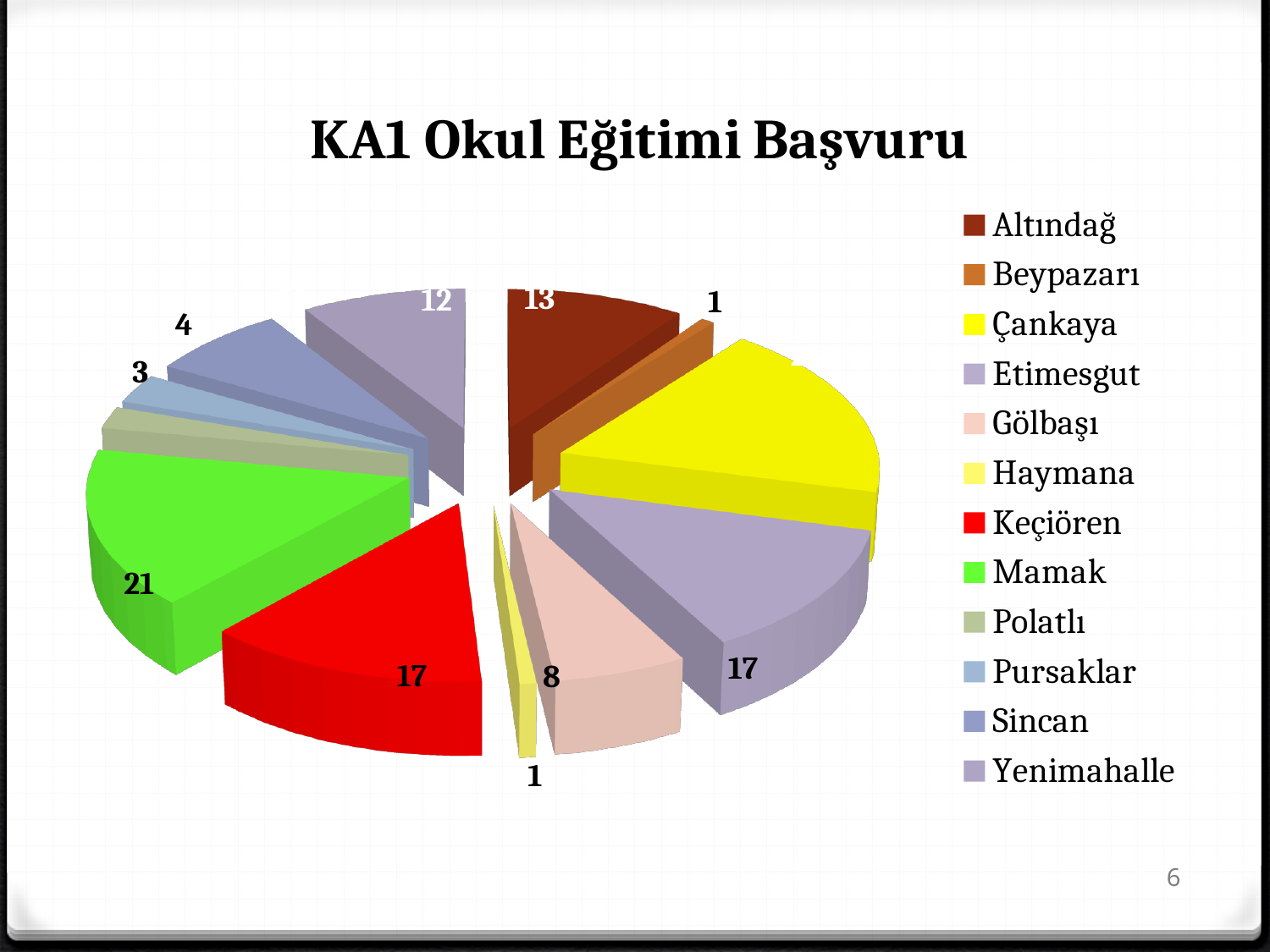
How many categories does the legend list? 12 What is the value for Pursaklar? 4 What is the difference between the values for Mamak and Keçiören? 4 What is the title of the chart? KA1 Okul Eğitimi Başvuru What is the value for Yenimahalle? 12 What is the value for Altındağ? 13 What is the value for Keçiören? 17 What is the value for Gölbaşı? 8 What is the value for Mamak? 21 Which is larger, the value for Altındağ or the value for Gölbaşı? Altındağ What kind of chart is shown on the slide? Pie chart